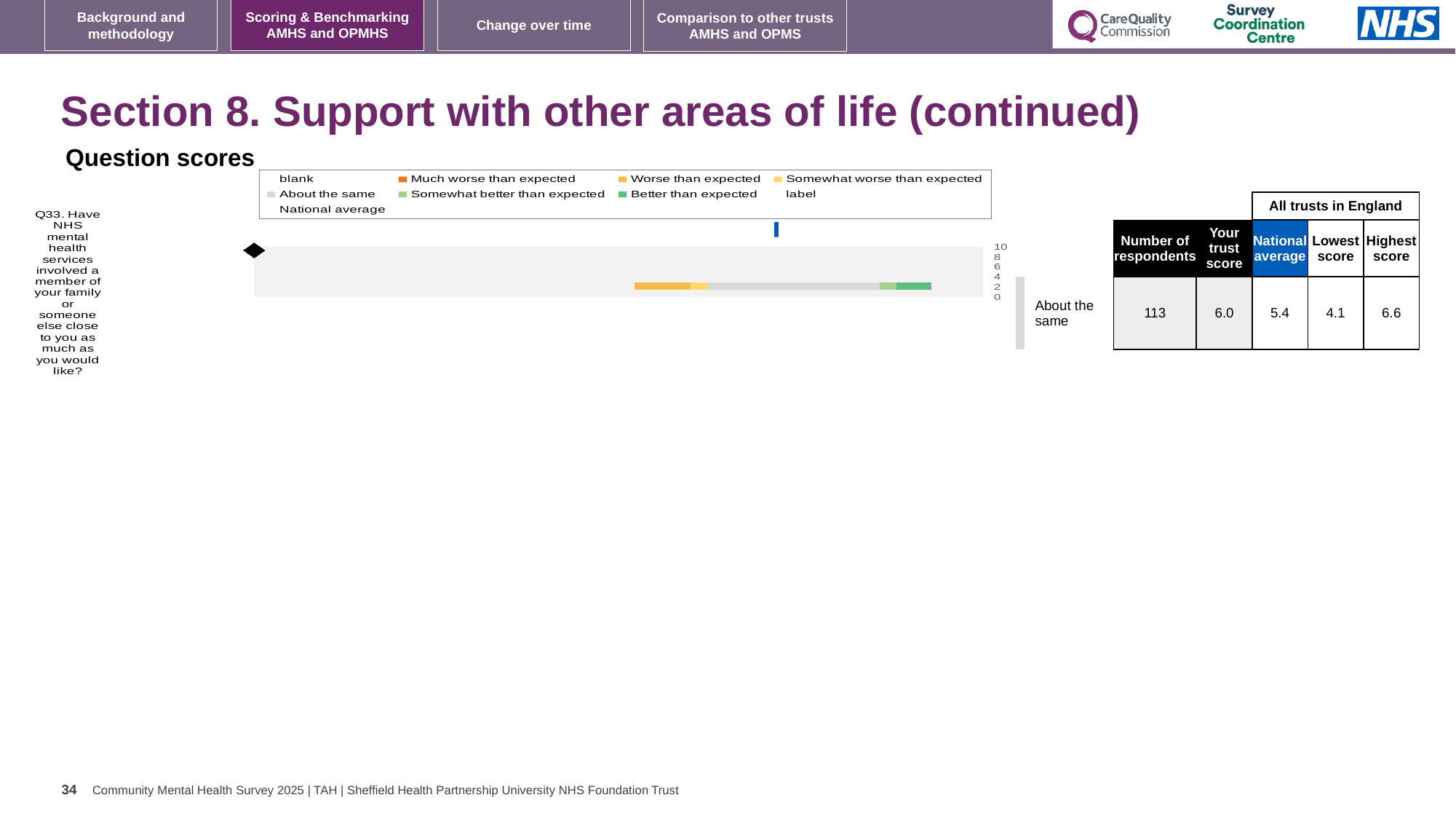
According to the table beside the chart, what is the lowest score among all trusts in England for Q33? 4.1 How many questions (categories) are plotted in the chart? 1 Is the trust's score for Q33 higher or lower than the national average? higher Which question is plotted in the chart? Q33. Have NHS mental health services involved a member of your family or someone else close to you as much as you would like? How many entries does the chart legend list? 9 How many respondents answered Q33, according to the table beside the chart? 113 According to the table beside the chart, what is the highest score among all trusts in England for Q33? 6.6 What kind of chart is shown under 'Question scores'? bar chart Which legend entry is shown in orange? Much worse than expected What is the difference between the trust's score and the national average for Q33? 0.6 According to the table beside the chart, what is the trust's score for Q33? 6.0 According to the table beside the chart, what is the national average for Q33? 5.4